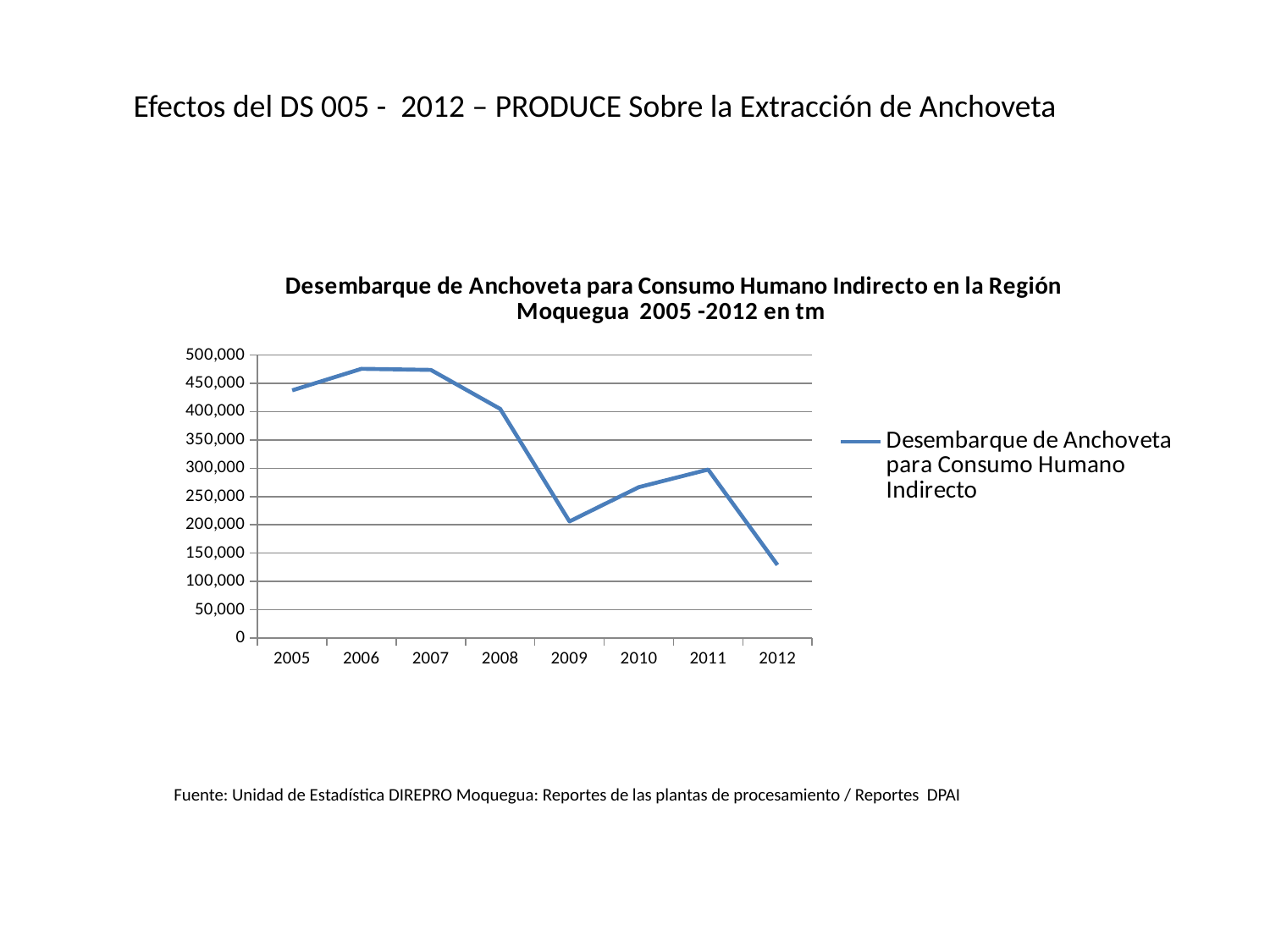
Which year has the larger value, 2011 or 2010? 2011 Is the value for 2006 greater or less than 450,000? greater Overall, do the values rise or fall from 2005 to 2012? fall How many series does the chart's legend list? 1 Is the value for 2012 greater or less than 150,000? less Is the value for 2008 greater or less than 350,000? greater How many years are plotted on the x axis of the chart? 8 What is the title of the chart? Desembarque de Anchoveta para Consumo Humano Indirecto en la Región Moquegua 2005 -2012 en tm Which year has the larger value, 2008 or 2009? 2008 Which year has the lowest value for Desembarque de Anchoveta para Consumo Humano Indirecto? 2012 What kind of chart is shown on the slide? line chart